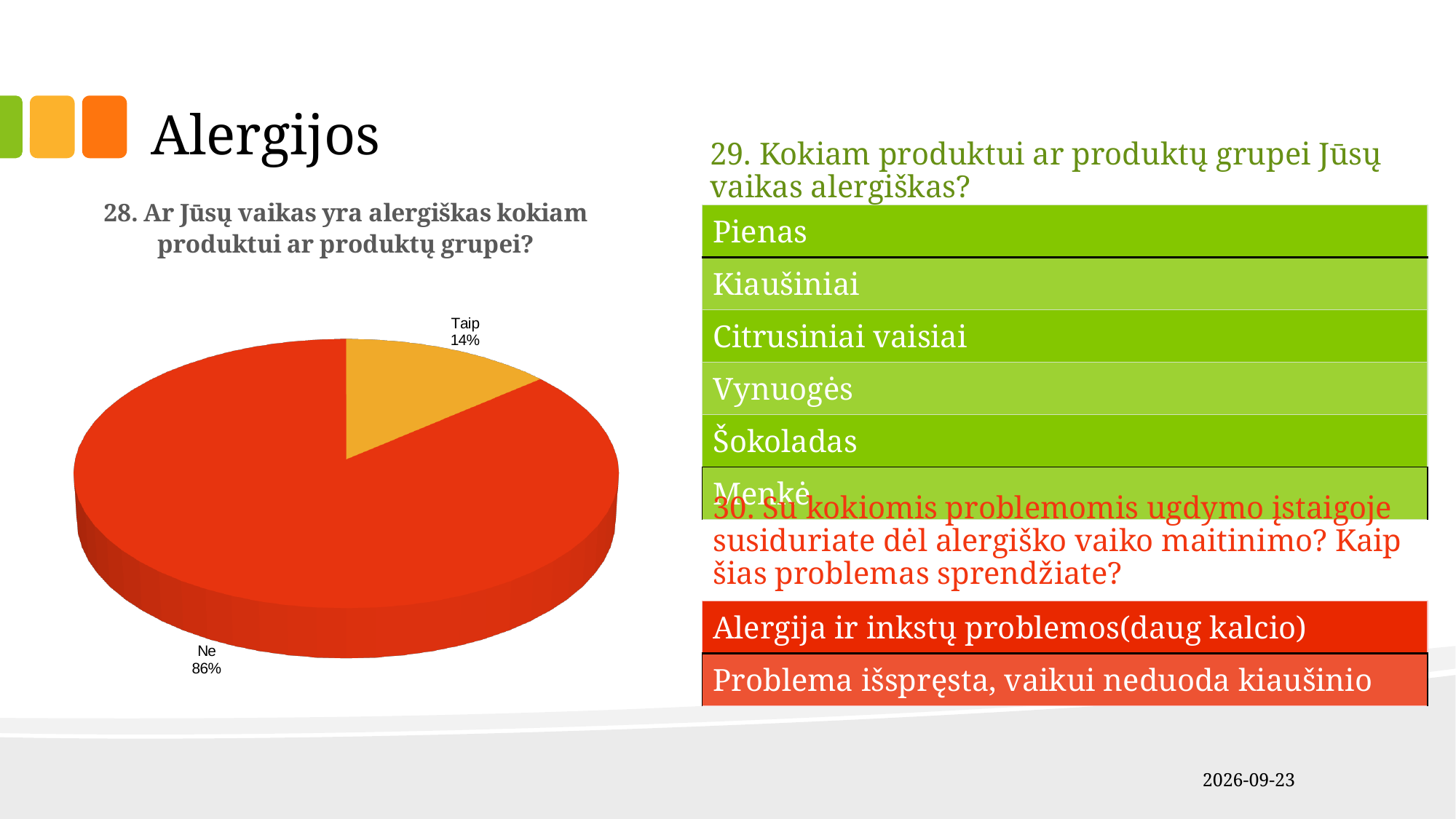
Which slice of the pie chart is the smallest? Taip Which is larger in the pie chart, "Taip" or "Ne"? Ne What colour is the "Ne" slice in the pie chart? red How many slices does the pie chart have? 2 What is the title of the pie chart? 28. Ar Jūsų vaikas yra alergiškas kokiam produktui ar produktų grupei? What kind of chart is shown on the slide? pie chart What is the difference between the "Ne" and "Taip" values in the pie chart? 72% What share of the pie does the "Taip" slice represent? 14% What is the value for "Ne" in the pie chart? 86% Which slice of the pie chart is the largest? Ne What is the value for "Taip" in the pie chart? 14%